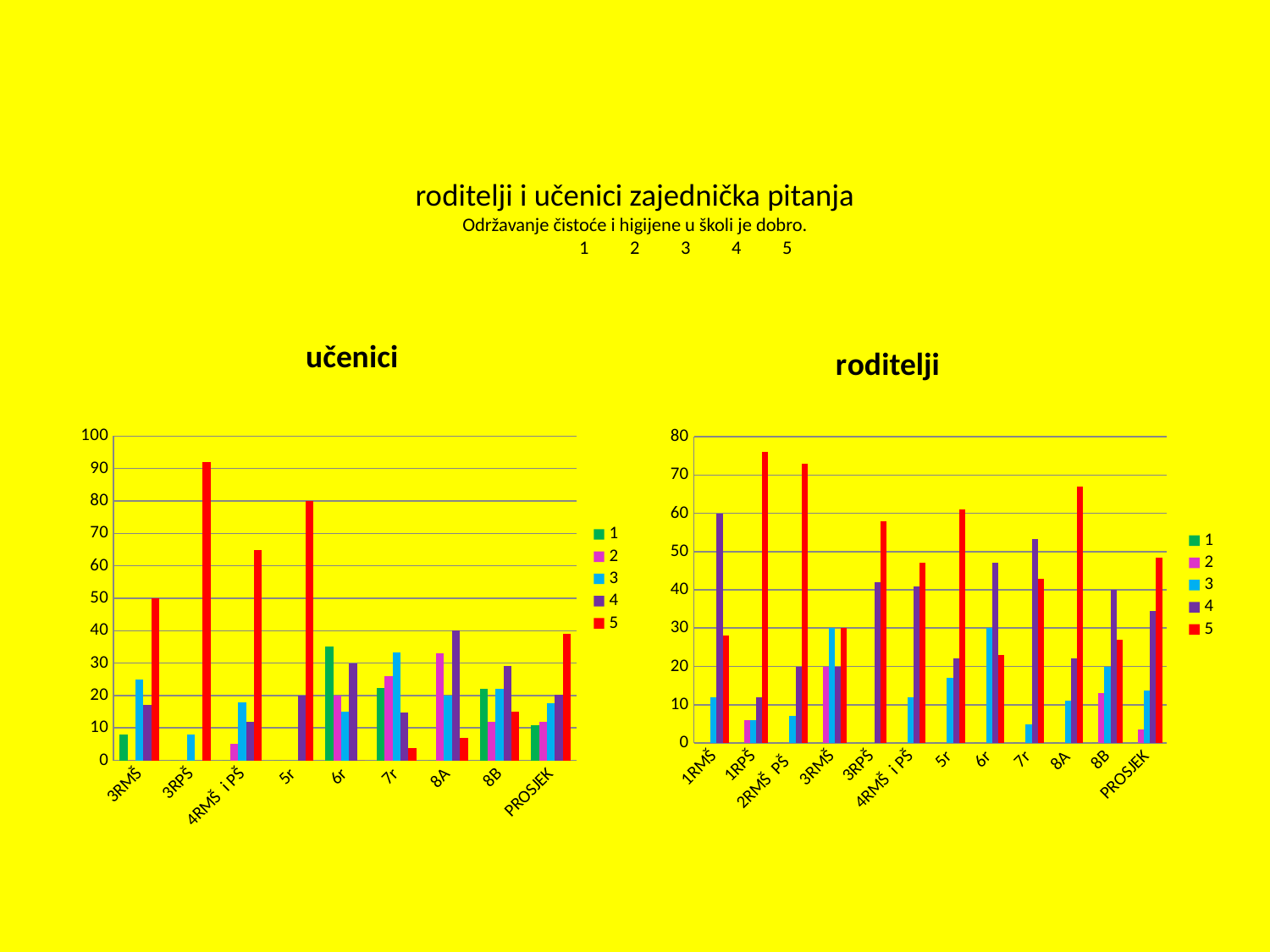
In the "učenici" chart, is the value of series 5 for 3RPŠ greater or less than 80? greater In the "učenici" chart, which category has the highest value for series 5? 3RPŠ In the "roditelji" chart, which category has the highest value for series 5? 1RPŠ In the "učenici" chart, is the value of series 1 for 6r greater or less than 30? greater What are the legend entries of the "roditelji" chart? 1, 2, 3, 4, 5 How many categories are shown on the x axis of the "roditelji" chart? 12 How many series does the legend of the "učenici" chart list? 5 How many categories are shown on the x axis of the "učenici" chart? 9 What kind of chart is the "učenici" chart? bar chart In the "roditelji" chart, which has the larger value for series 5: 8A or 8B? 8A In the "učenici" chart, is the value of series 5 for 5r larger than the value of series 5 for 6r? yes In the "roditelji" chart, is the value of series 4 for 1RMŠ greater or less than 50? greater